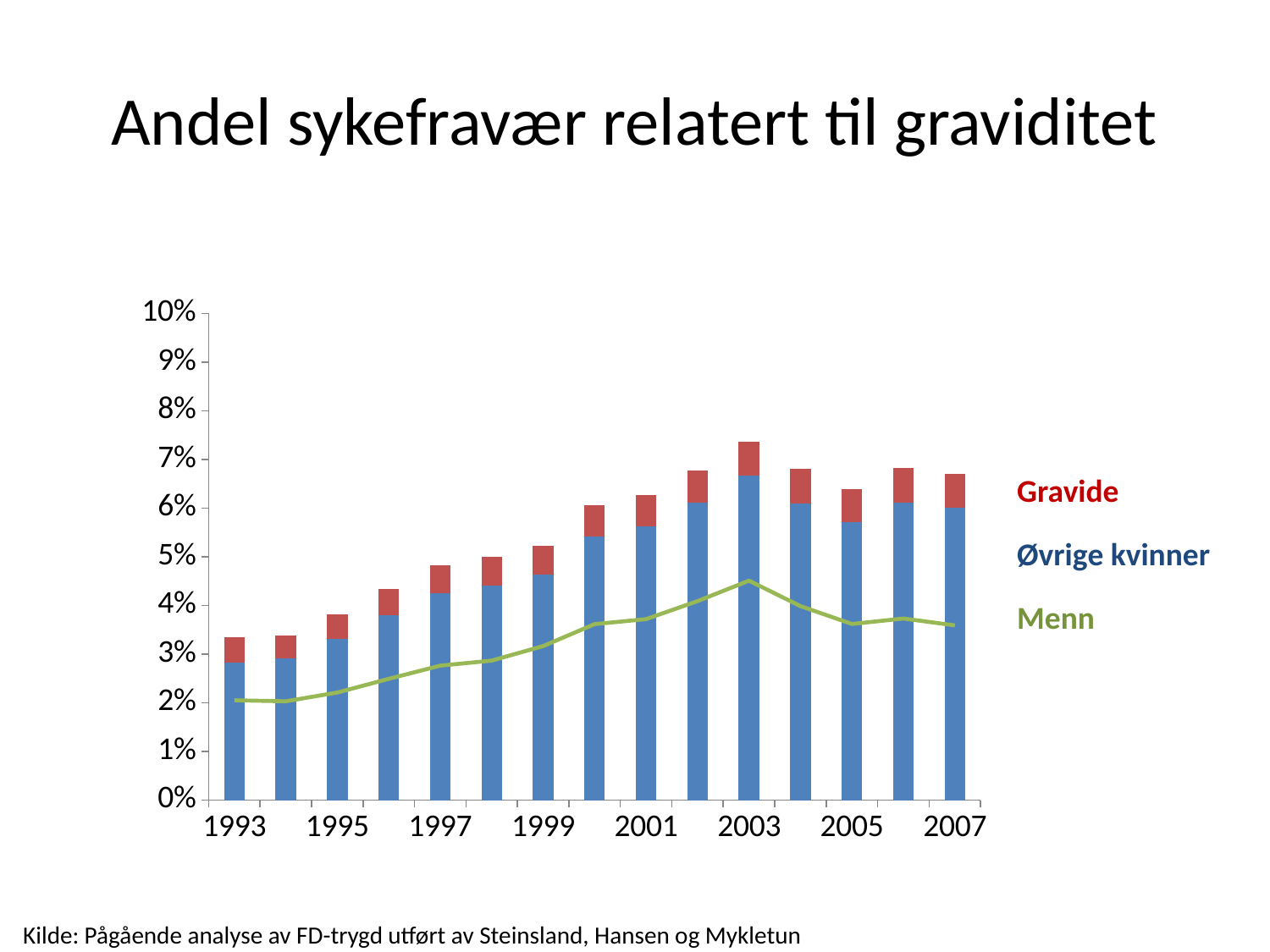
How many years (bars) are plotted on the x axis? 15 In which year does the Menn line reach its highest value? 2003 In which year is the total stacked bar (Gravide plus Øvrige kvinner) highest? 2003 Is the total stacked bar for 2003 greater or less than 7%? greater What is the title of the chart? Andel sykefravær relatert til graviditet Is the value for Menn in 2003 greater or less than 4%? greater Which series is shown as a line rather than bars? Menn What kind of chart is shown on the slide? Bar chart with a line Is the total stacked bar for 1993 greater or less than 4%? less How many series does the legend list? 3 Does the Menn line rise or fall from 1993 to 2003? rise